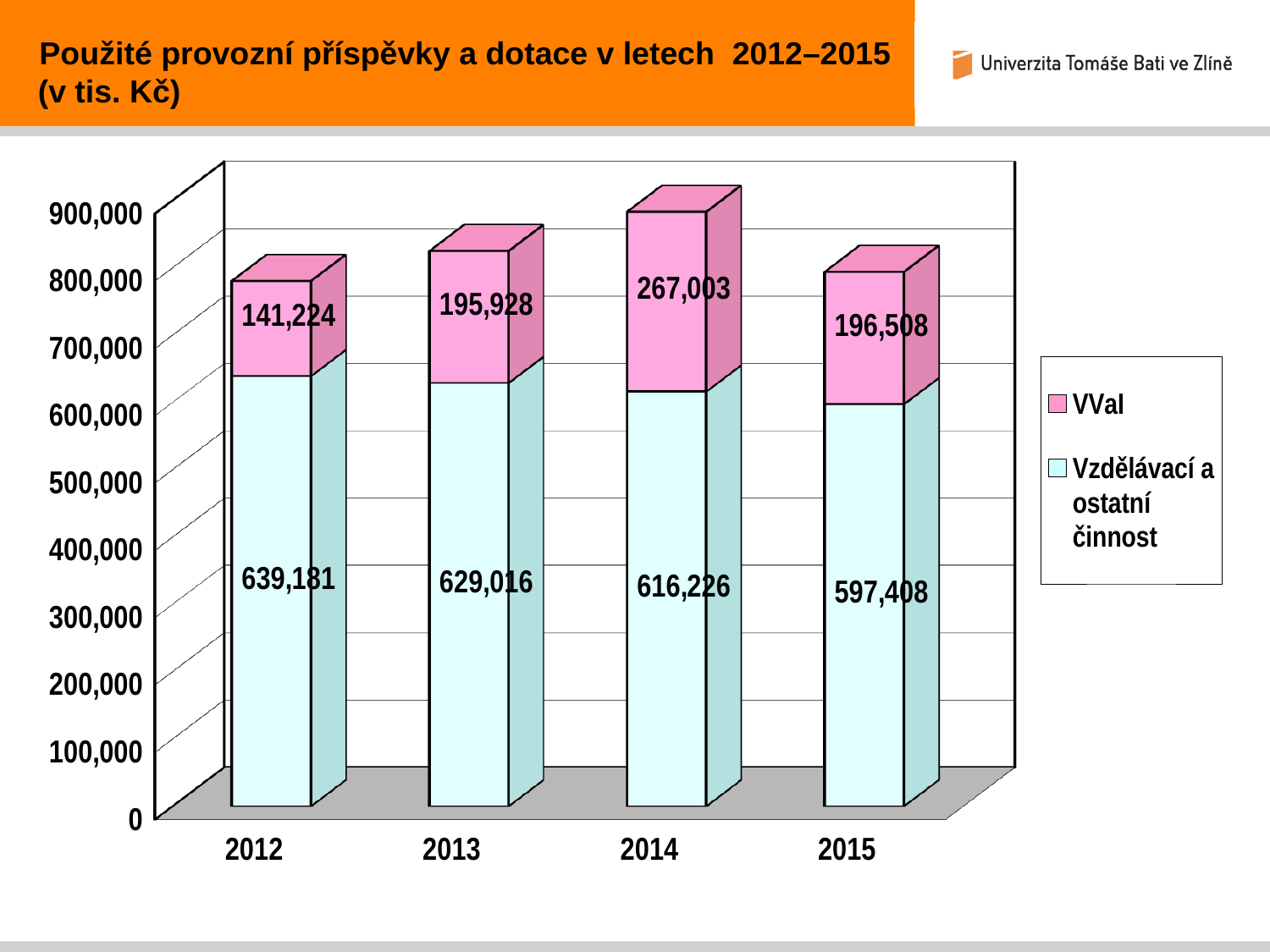
What is the difference between the Vzdělávací a ostatní činnost values for 2012 and 2013? 10,165 What is the total of the stacked bar for 2012? 780,405 What is the value for VVaI in 2014? 267,003 What kind of chart is shown on the slide? Stacked bar chart What is the total of the stacked bar for 2014? 883,229 What is the value for Vzdělávací a ostatní činnost in 2015? 597,408 In which year is the VVaI value highest? 2014 How many series does the legend list? 2 In which year is the Vzdělávací a ostatní činnost value lowest? 2015 How many years are shown on the x axis? 4 Which is larger: the VVaI value for 2013 or for 2015? 2015 What is the value for VVaI in 2012? 141,224